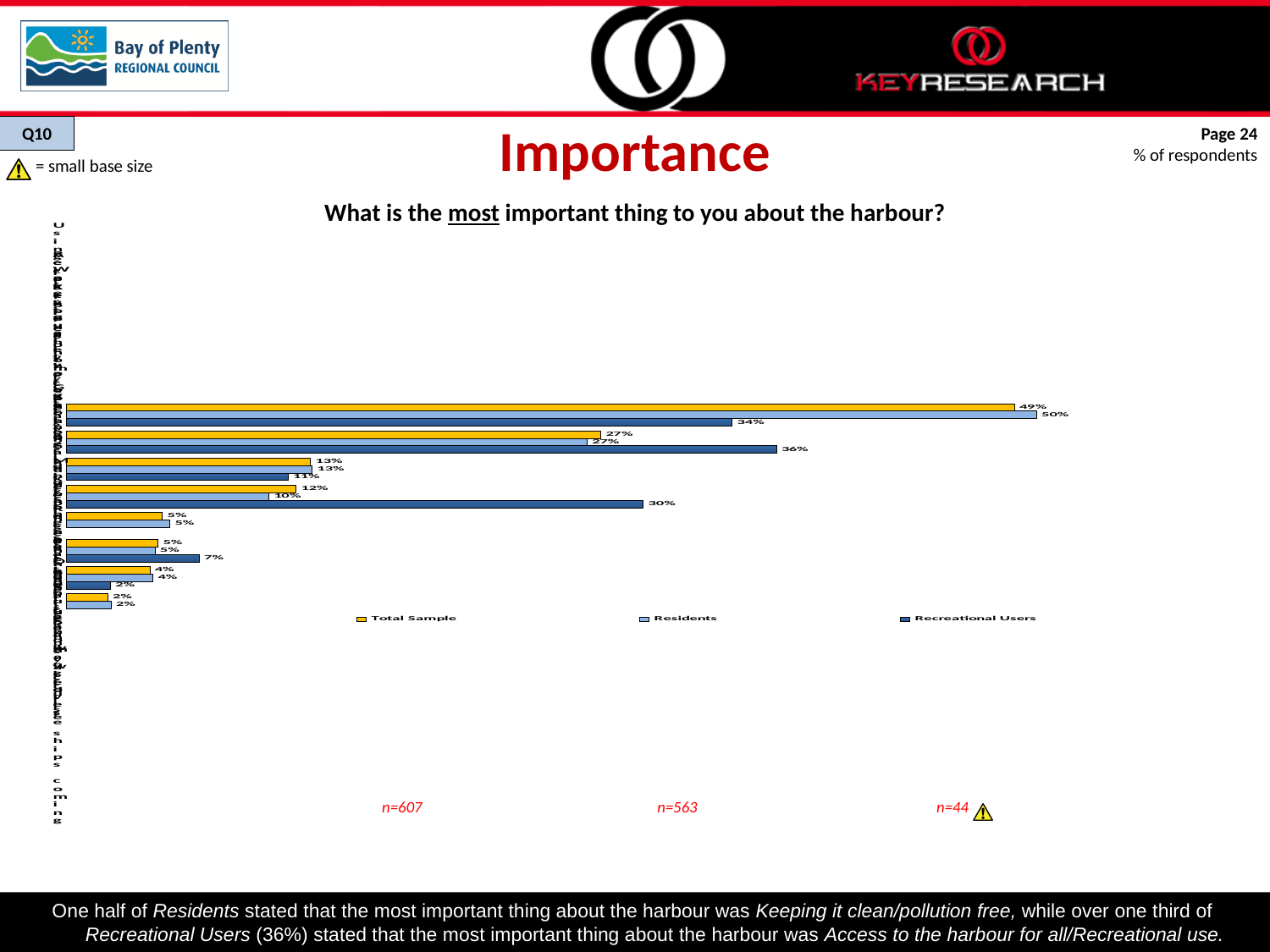
How many series does the chart legend list? 3 What kind of chart is shown on the slide? Bar chart In the top group of bars, what is the value for Recreational Users? 34% In the second group of bars from the top, what is the value for Total Sample? 27% In the top group of bars, what is the value for Residents? 50% In the second group of bars from the top, what is the value for Recreational Users? 36% What is the sample size (n) shown for Recreational Users? n=44 In the top group of bars, what is the difference between the Residents value and the Recreational Users value? 16 percentage points In the top group of bars, which series has the lowest value? Recreational Users In the top group of bars, what is the value for Total Sample? 49% What are the three series named in the chart legend? Total Sample, Residents, Recreational Users In the fourth group of bars from the top, which is larger: the Recreational Users value or the Total Sample value? Recreational Users